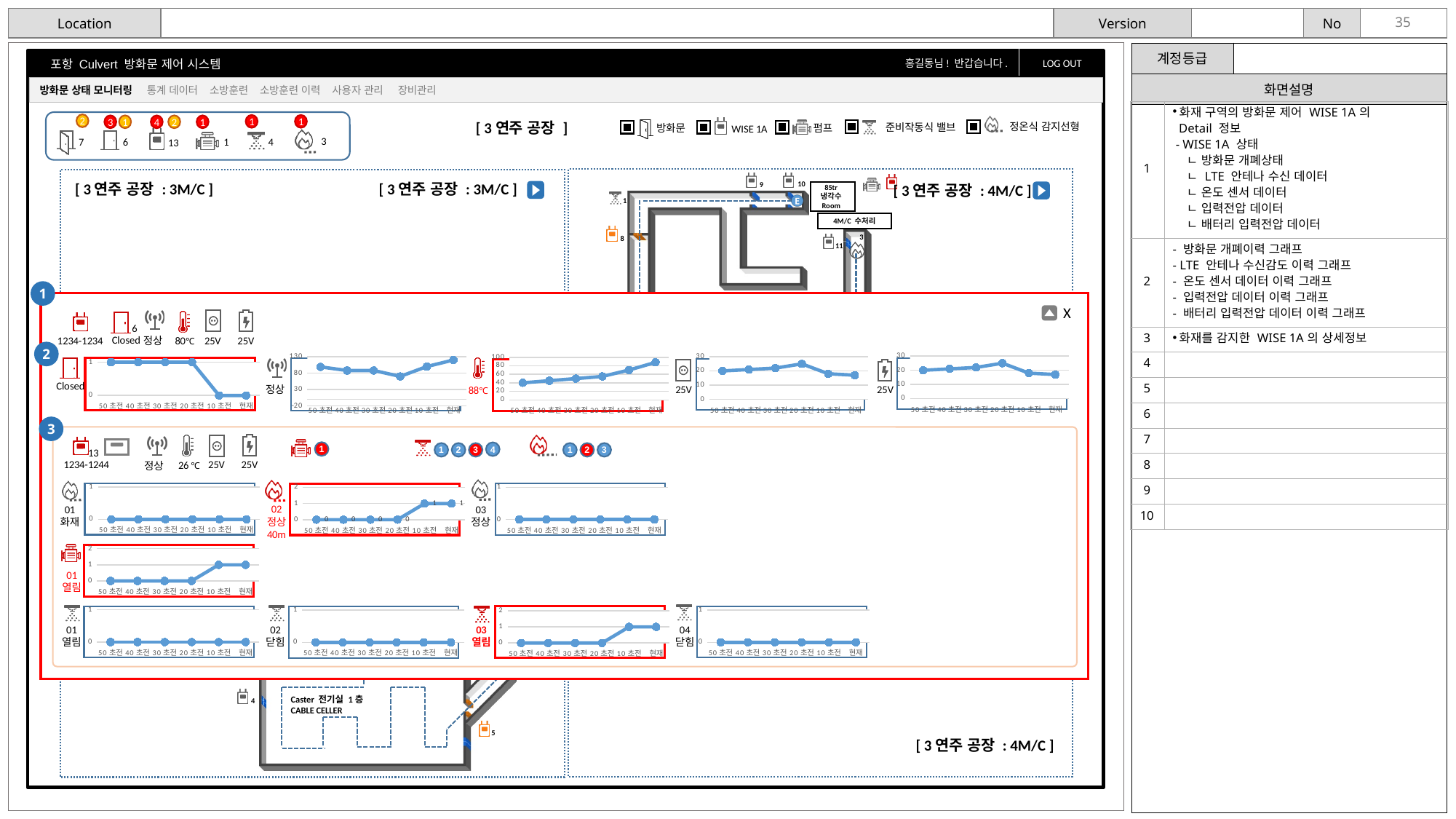
In the door open/close history chart (labelled Closed) in section 2, do the values rise or fall from 50 초전 to 현재? fall In the LTE antenna signal chart (labelled 정상) in section 2, is the value at 현재 greater or less than 80? greater In the temperature history chart (labelled 88℃) in section 2, is the value at 현재 greater or less than 80? greater How many time points are plotted on the x axis of the temperature history chart (labelled 88℃) in section 2? 6 In the input voltage chart (labelled 25V, fourth chart) in section 2, is the value at 현재 greater or less than 10? greater In the fire sensor 02 chart (labelled 02 정상 40m) in section 3, what is the data label value at 50 초전? 0 In the fire sensor 02 chart (labelled 02 정상 40m) in section 3, what is the data label value at 현재? 1 What is the last x-axis label on the pump 01 chart (labelled 01 열림) in section 3? 현재 What kind of chart is used for the door open/close history (labelled Closed) in section 2? line chart In the temperature history chart (labelled 88℃) in section 2, do the values rise or fall from 50 초전 to 현재? rise